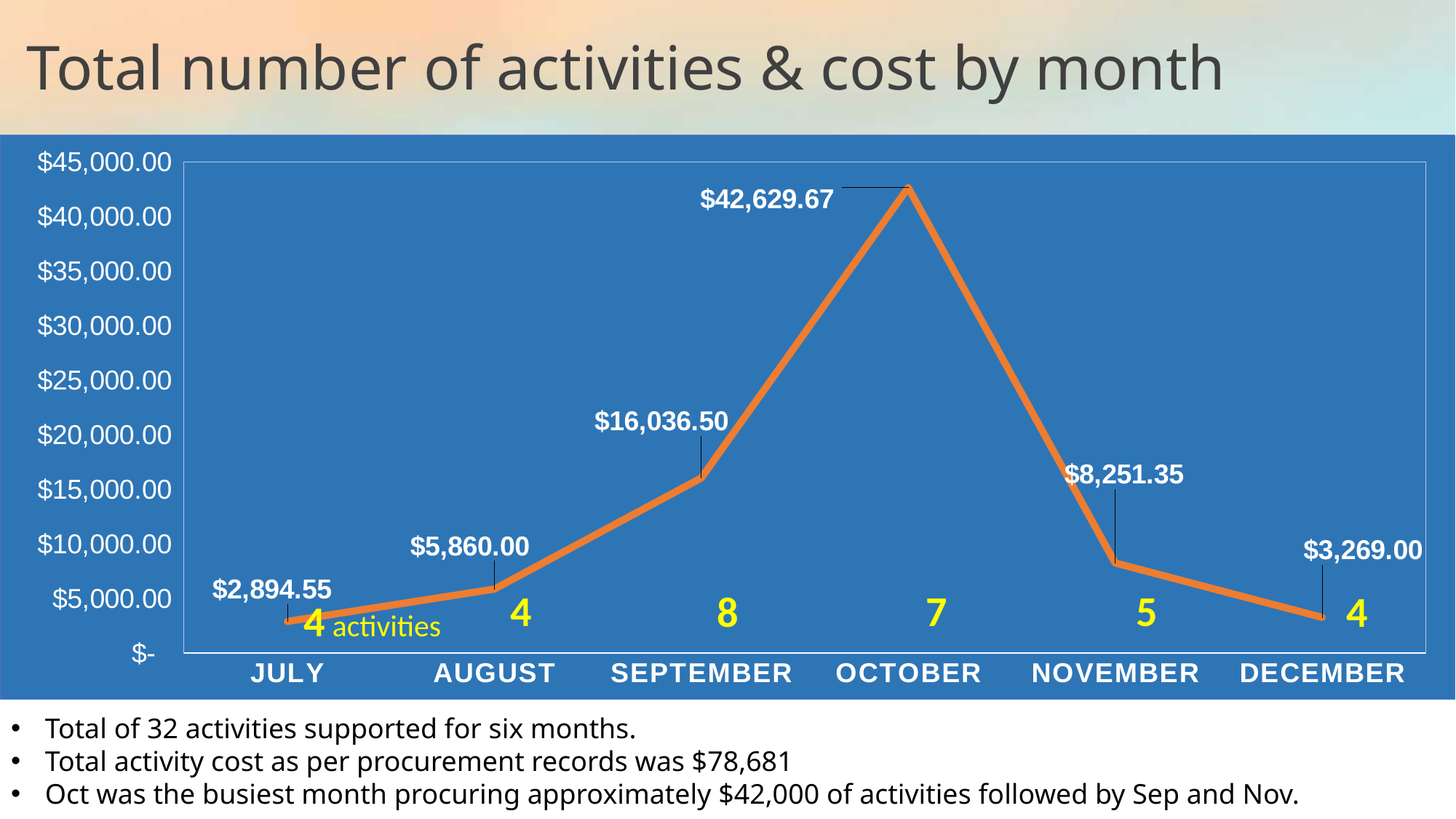
What is the difference in cost between November and December? $4,982.35 How many activities are shown for September? 8 What is the cost shown for July? $2,894.55 What is the cost shown for October? $42,629.67 How many months are plotted on the x axis? 6 What is the difference in cost between October and September? $26,593.17 Which month has the higher cost, August or December? August How does the cost change from July to October? It rises What is the cost shown for November? $8,251.35 Which month has the lowest cost? July Which month has the highest cost? October What kind of chart is shown on the slide? Line chart